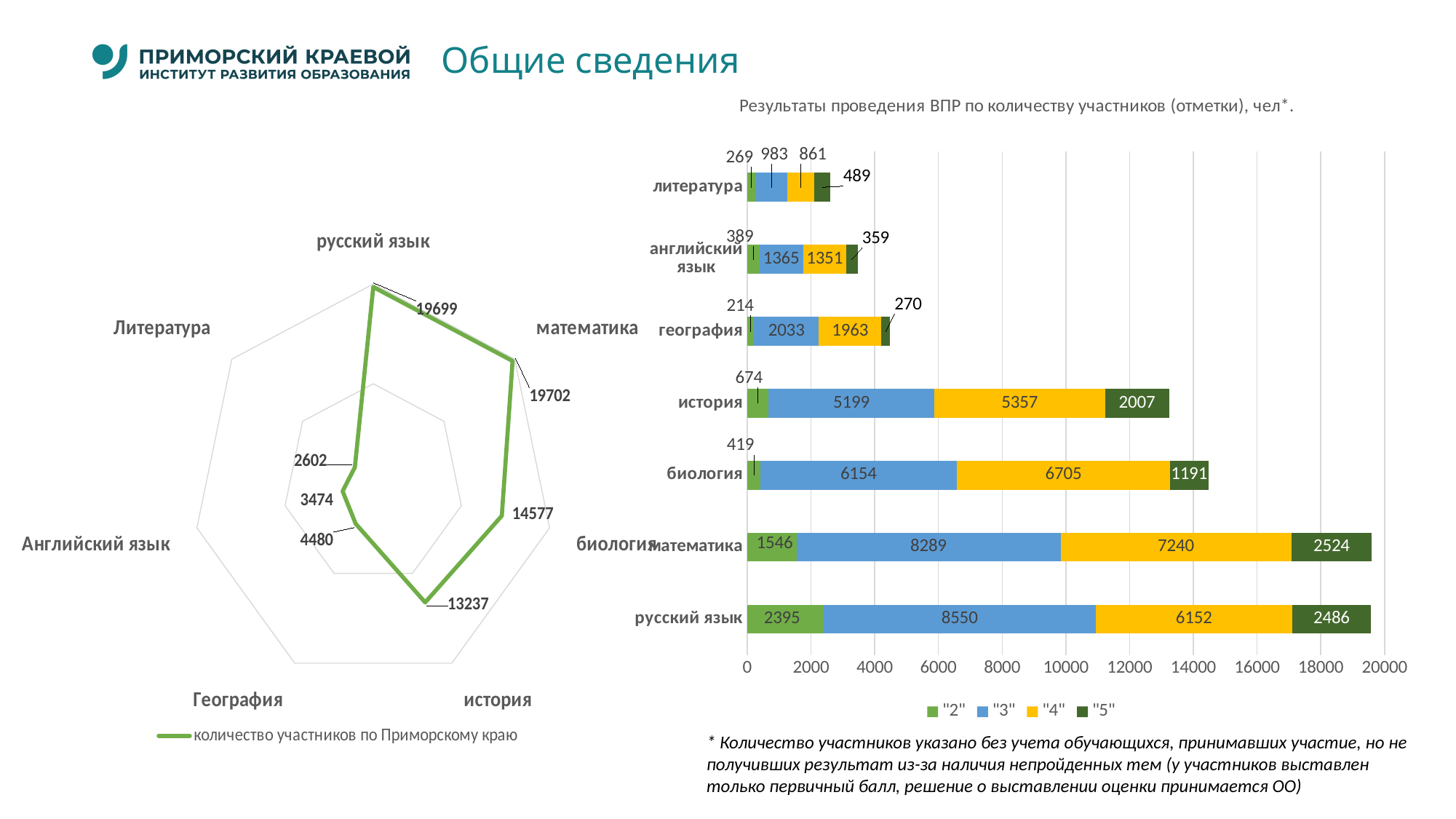
In the radar chart on the left, what is the number of participants for история? 13237 How many series does the legend of the stacked bar chart on the right list? 4 In the radar chart on the left, which subject has the lowest number of participants? Литература In the stacked bar chart on the right, which has the larger "5" value: математика or русский язык? математика In the stacked bar chart on the right, how many participants received a "4" in история? 5357 In the radar chart on the left, what is the difference between the values for География and Английский язык? 1006 How many subjects (categories) are shown in the stacked bar chart on the right? 7 In the stacked bar chart on the right, how many participants received a "2" in математика? 1546 In the stacked bar chart on the right, which subject has the highest "3" value? русский язык In the stacked bar chart on the right, what is the total of the история bar? 13237 In the stacked bar chart on the right, what is the difference between the "4" and "3" values for биология? 551 What kind of chart is the chart on the right of the slide? Stacked bar chart